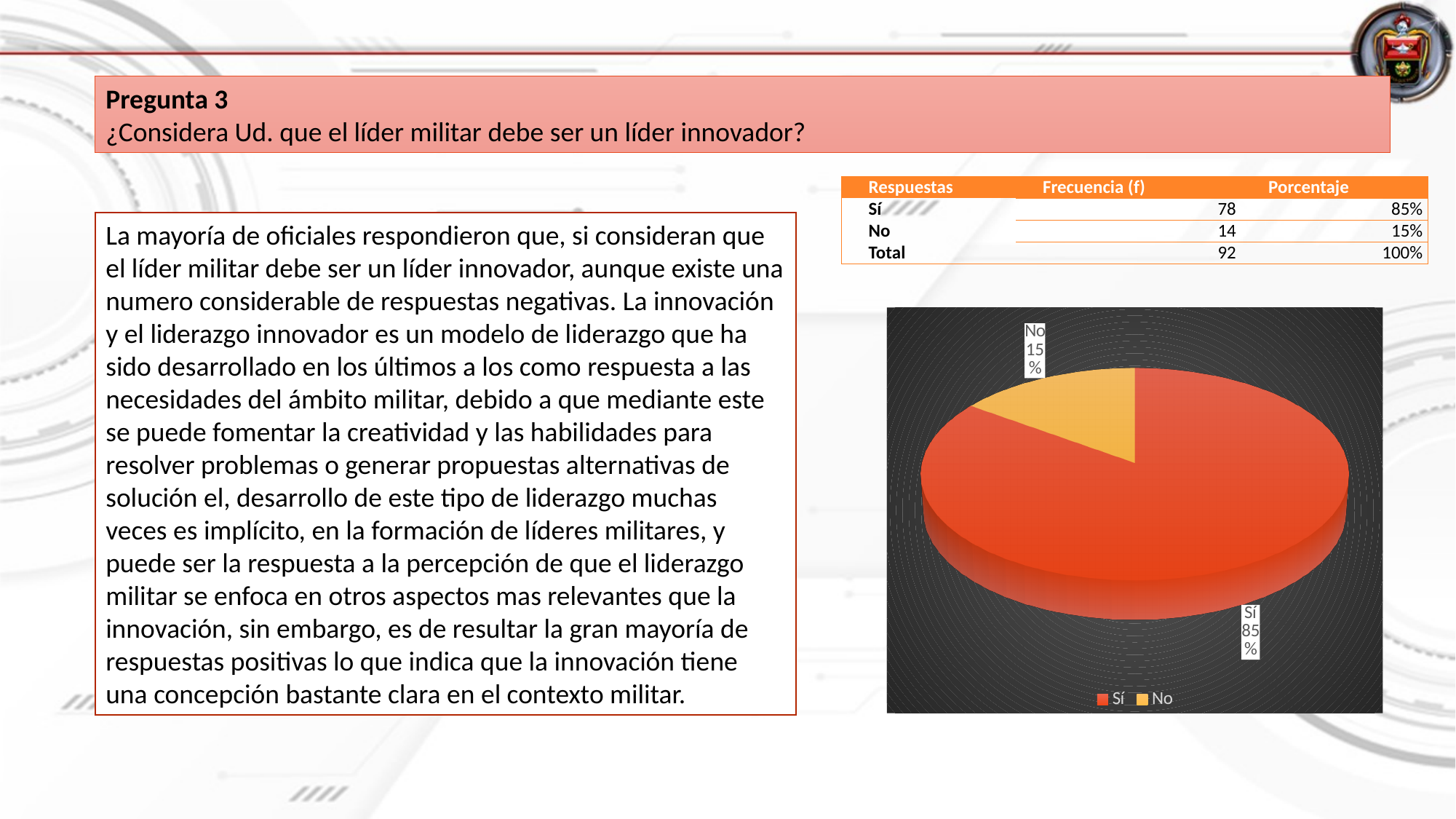
What are the two legend entries of the pie chart? Sí and No What share of the pie does the "No" slice represent? 15% How many entries does the legend of the pie chart list? 2 What is the difference in percentage points between the "Sí" and "No" slices? 70 percentage points How many slices does the pie chart have? 2 Which slice of the pie chart is the smallest? No What kind of chart is shown on the slide? pie chart What share of the pie does the "Sí" slice represent? 85% Which is larger in the pie chart, the "Sí" slice or the "No" slice? Sí What colour is the "No" slice in the pie chart? yellow Which slice of the pie chart is the largest? Sí